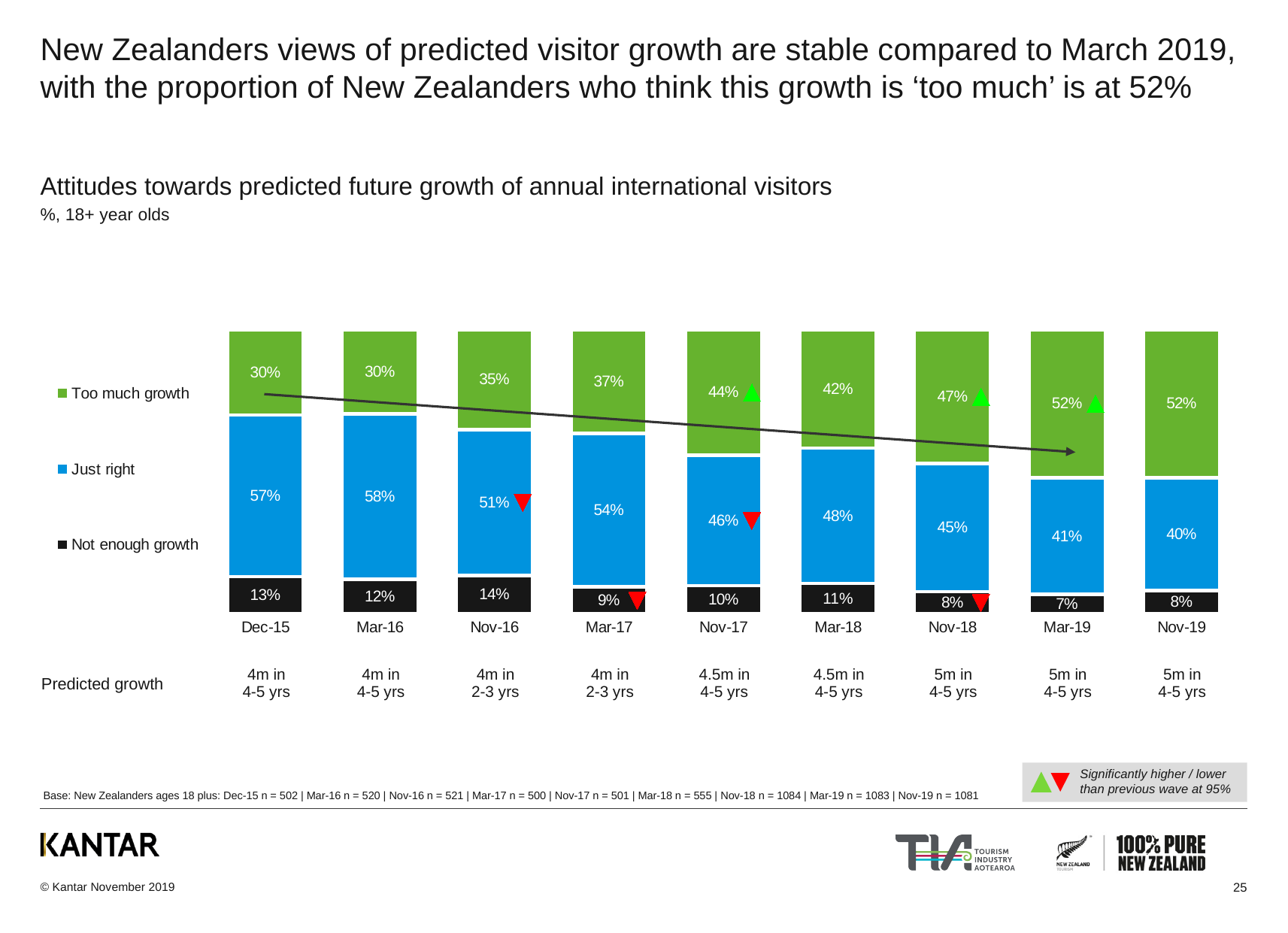
What is the predicted growth shown under the Nov-17 bar? 4.5m in 4-5 yrs Does the 'Just right' share rise or fall from Mar-17 to Nov-19? Fall In which wave was 'Just right' highest? Mar-16 In which wave was 'Too much growth' lowest? Dec-15 and Mar-16 (30%) What was the 'Just right' value in Mar-16? 58% What kind of chart is shown? Stacked bar chart How many survey waves are shown on the x axis? 9 What was the 'Not enough growth' value in Nov-16? 14% What percentage of New Zealanders said 'Too much growth' in Nov-19? 52% Which is larger in Nov-17: 'Too much growth' or 'Just right'? Just right What is the difference between the 'Too much growth' values in Mar-19 and Dec-15? 22 percentage points How many series does the legend list? 3